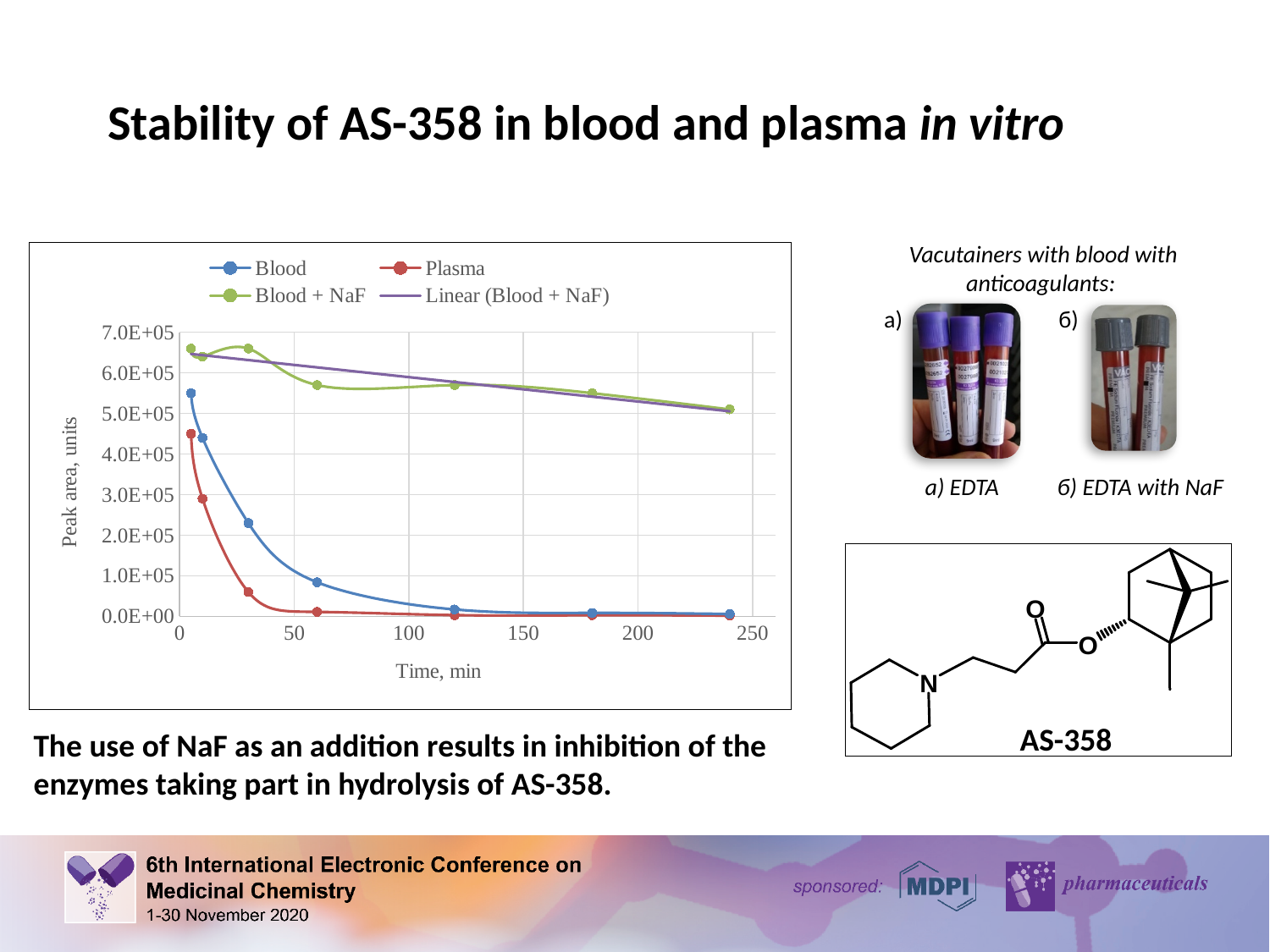
Which series has the highest value at 240 min? Blood + NaF How many entries does the chart legend list? 4 At 30 min, which series has the larger value, Blood or Plasma? Blood Is the value for Blood at 5 min greater or less than 5.0E+05? greater Is the value for Plasma at 60 min greater or less than 1.0E+05? less What is the label of the x axis of the chart? Time, min What is the label of the y axis of the chart? Peak area, units Is the value for Blood + NaF at 240 min greater or less than 4.0E+05? greater Does the Plasma series rise or fall as time increases? fall What kind of chart is shown on the slide? line chart Does the Blood series rise or fall as time increases? fall